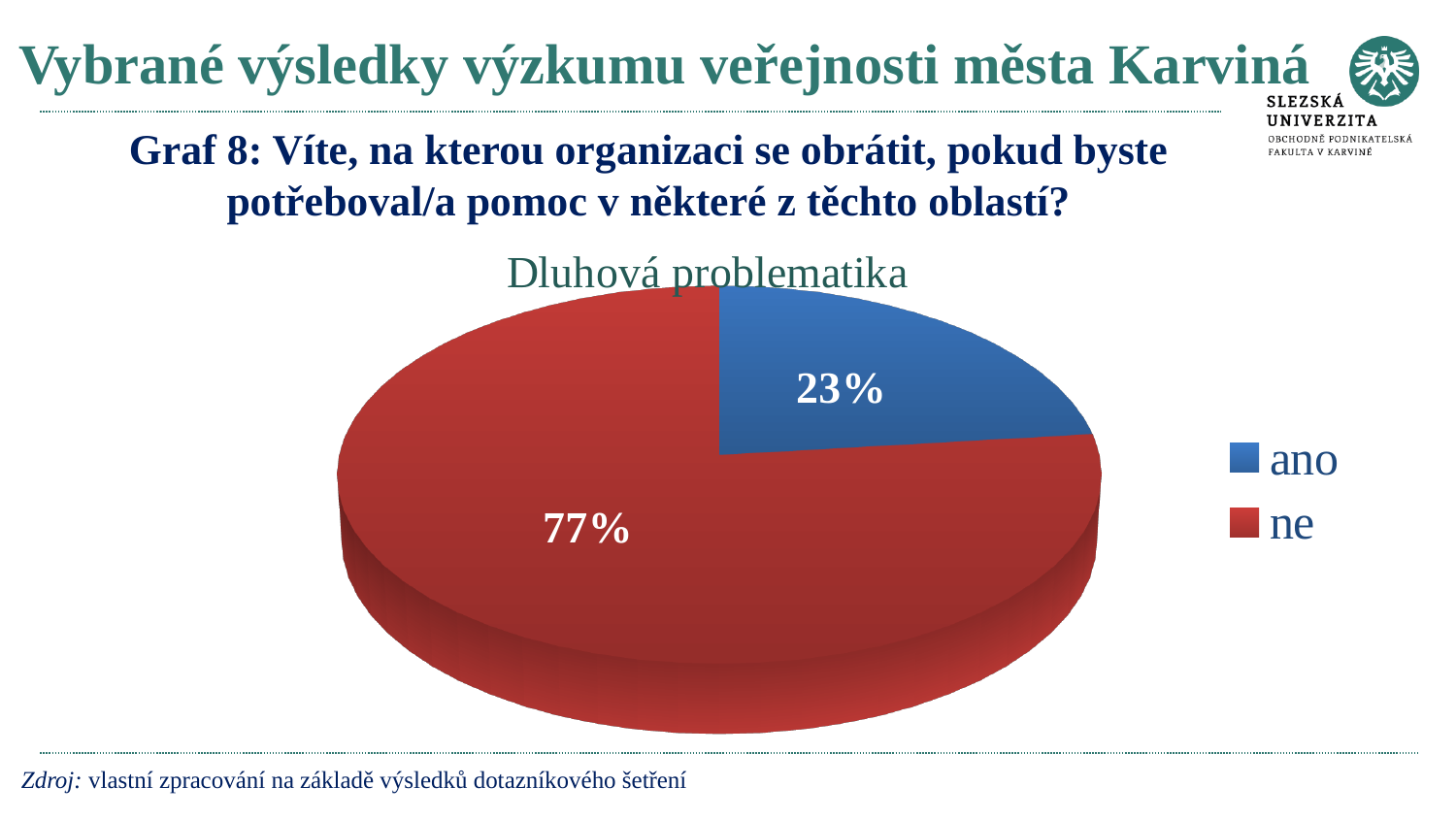
How many slices does the pie chart have? 2 What is the title of the pie chart? Dluhová problematika How many entries does the legend of the pie chart list? 2 What percentage of the pie chart is labelled "ne"? 77% What percentage of the pie chart is labelled "ano"? 23% What kind of chart is shown on the slide? pie chart What colour is the "ne" slice in the pie chart? red What is the difference in percentage points between the "ne" slice and the "ano" slice? 54 What share of the pie does the "ano" slice represent? 23% Which slice of the pie chart is the largest? ne Which is larger in the pie chart, "ano" or "ne"? ne Which slice of the pie chart is the smallest? ano